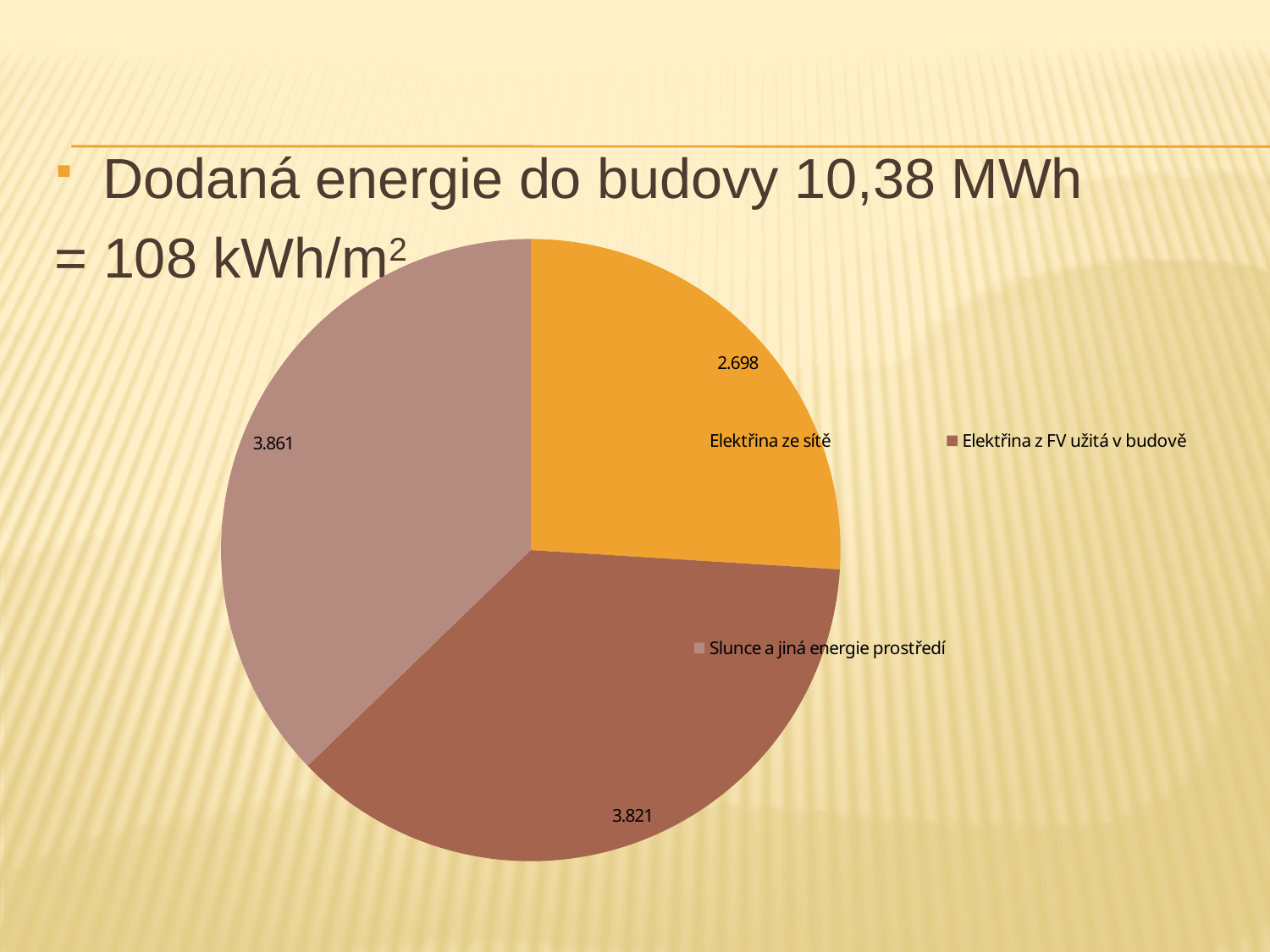
How many entries does the legend list? 3 What is the value for Elektřina z FV užitá v budově? 3.821 Which category has the largest value in the pie chart? Slunce a jiná energie prostředí What kind of chart is shown on the slide? pie chart What is the difference between the values for Slunce a jiná energie prostředí and Elektřina ze sítě? 1.163 What is the value for Slunce a jiná energie prostředí? 3.861 What is the value for Elektřina ze sítě? 2.698 What colour is the slice for Elektřina ze sítě? orange Which category has the smallest slice of the pie? Elektřina ze sítě How many slices does the pie chart have? 3 Which is larger, the value for Elektřina z FV užitá v budově or the value for Elektřina ze sítě? Elektřina z FV užitá v budově What is the difference between the values for Elektřina z FV užitá v budově and Elektřina ze sítě? 1.123